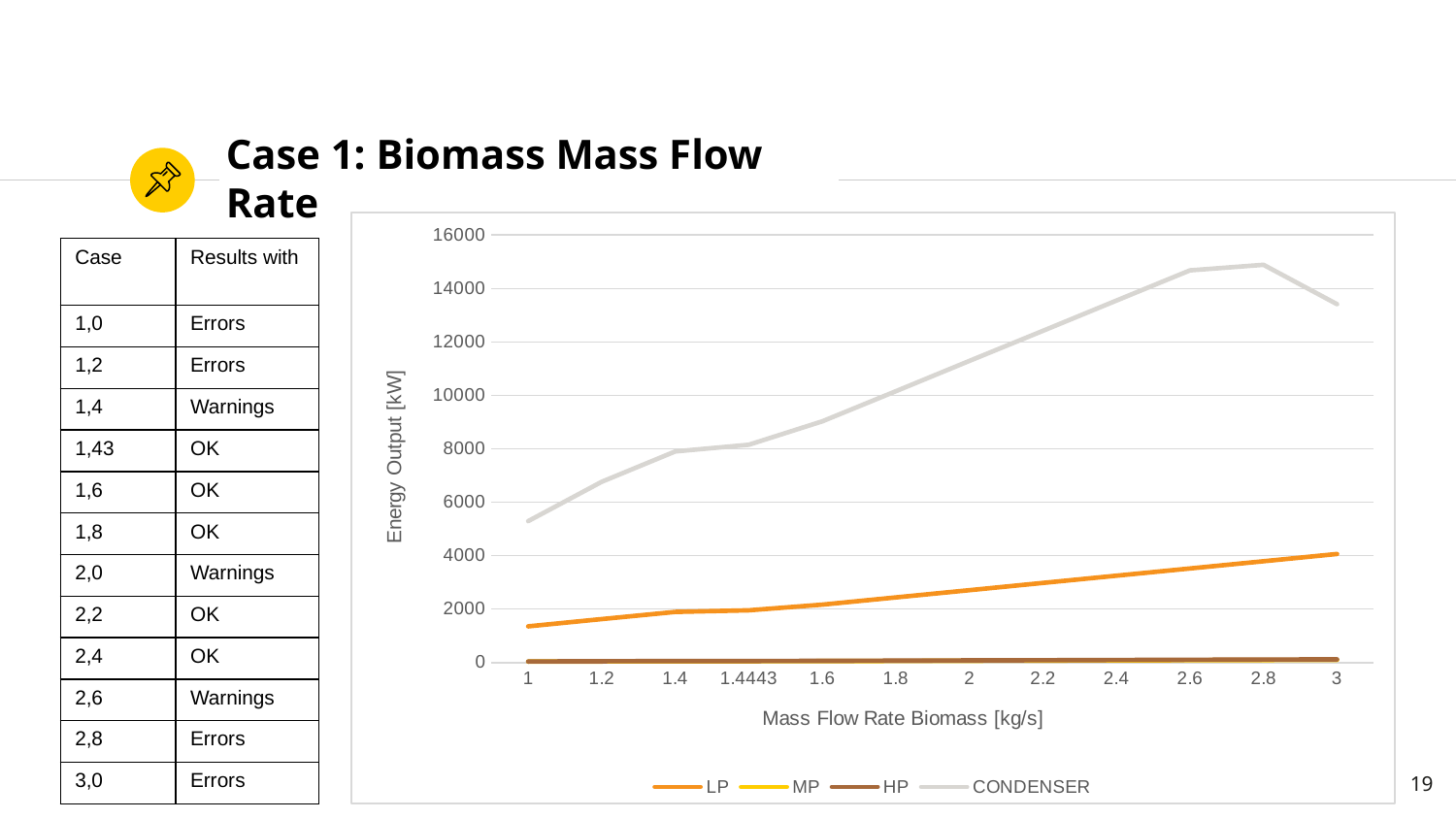
At a mass flow rate of 3 kg/s, is the LP value greater or less than 3000? greater At a mass flow rate of 1 kg/s, is the LP value greater or less than 2000? less At a mass flow rate of 2 kg/s, is the CONDENSER value greater or less than 10000? greater Which series has the highest energy output across the chart? CONDENSER At a mass flow rate of 2.2 kg/s, which is larger, the CONDENSER value or the LP value? CONDENSER What kind of chart is shown on the slide? line chart What is the label of the chart's y axis? Energy Output [kW] How many mass flow rate values are plotted along the x axis? 12 At which mass flow rate is the CONDENSER energy output lowest? 1 How many series does the chart legend list? 4 Does the LP energy output rise or fall as the mass flow rate increases from 1 to 3 kg/s? rise